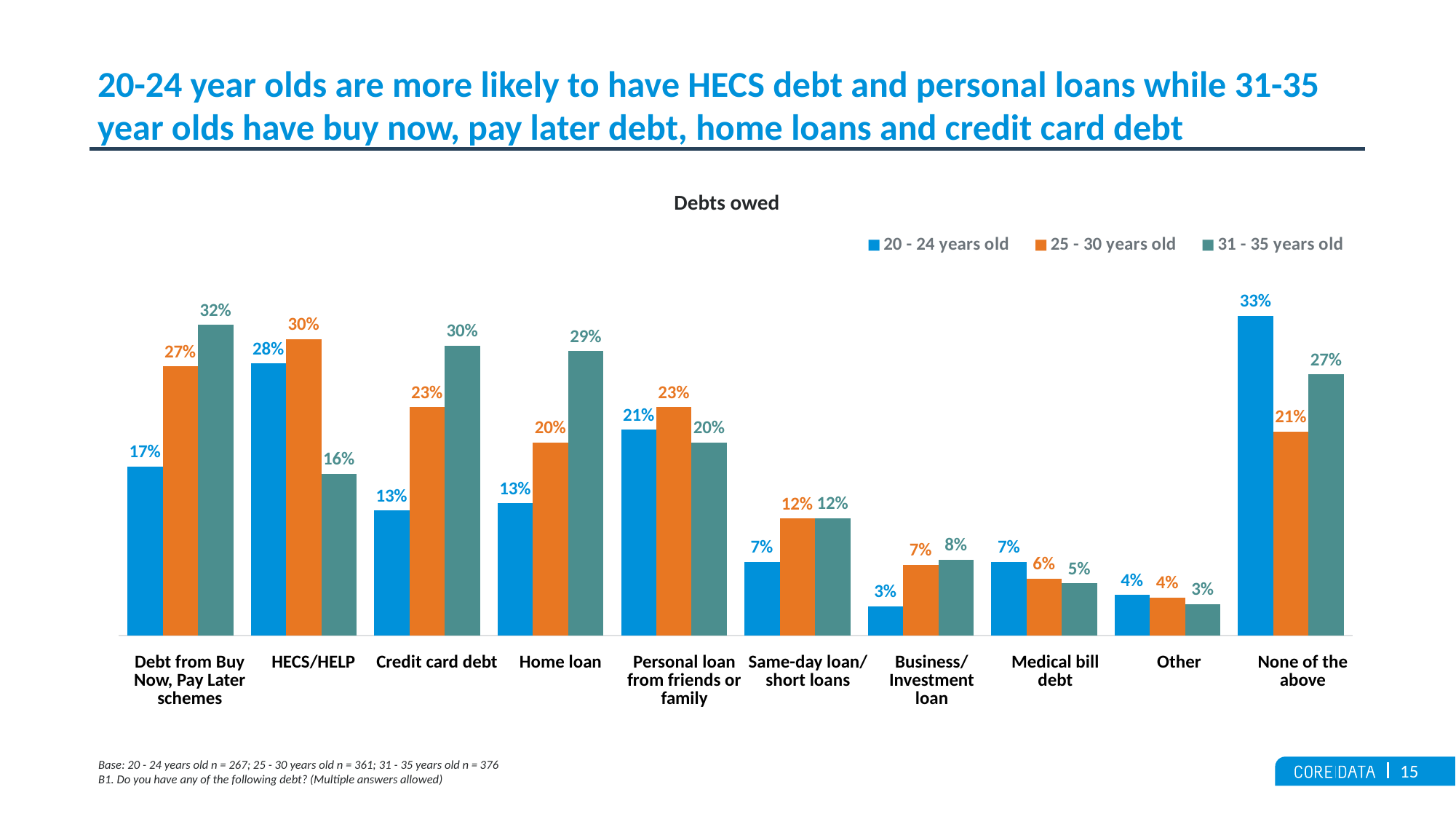
Which category has the lowest value for 31 - 35 years old? Other What is the difference between the 31 - 35 years old and 20 - 24 years old values for Debt from Buy Now, Pay Later schemes? 15% For HECS/HELP, which is larger: the value for 25 - 30 years old or 31 - 35 years old? 25 - 30 years old What percentage of 20 - 24 year olds have HECS/HELP debt? 28% What kind of chart is shown on the slide? Bar chart What is the value for 31 - 35 years old for Home loan? 29% How many debt categories are shown on the x axis? 10 What is the difference between the 20 - 24 years old and 25 - 30 years old values for None of the above? 12% How many series does the legend list? 3 Which category has the highest value for 20 - 24 years old? None of the above What percentage of 25 - 30 year olds have Credit card debt? 23% What is the title of the chart? Debts owed